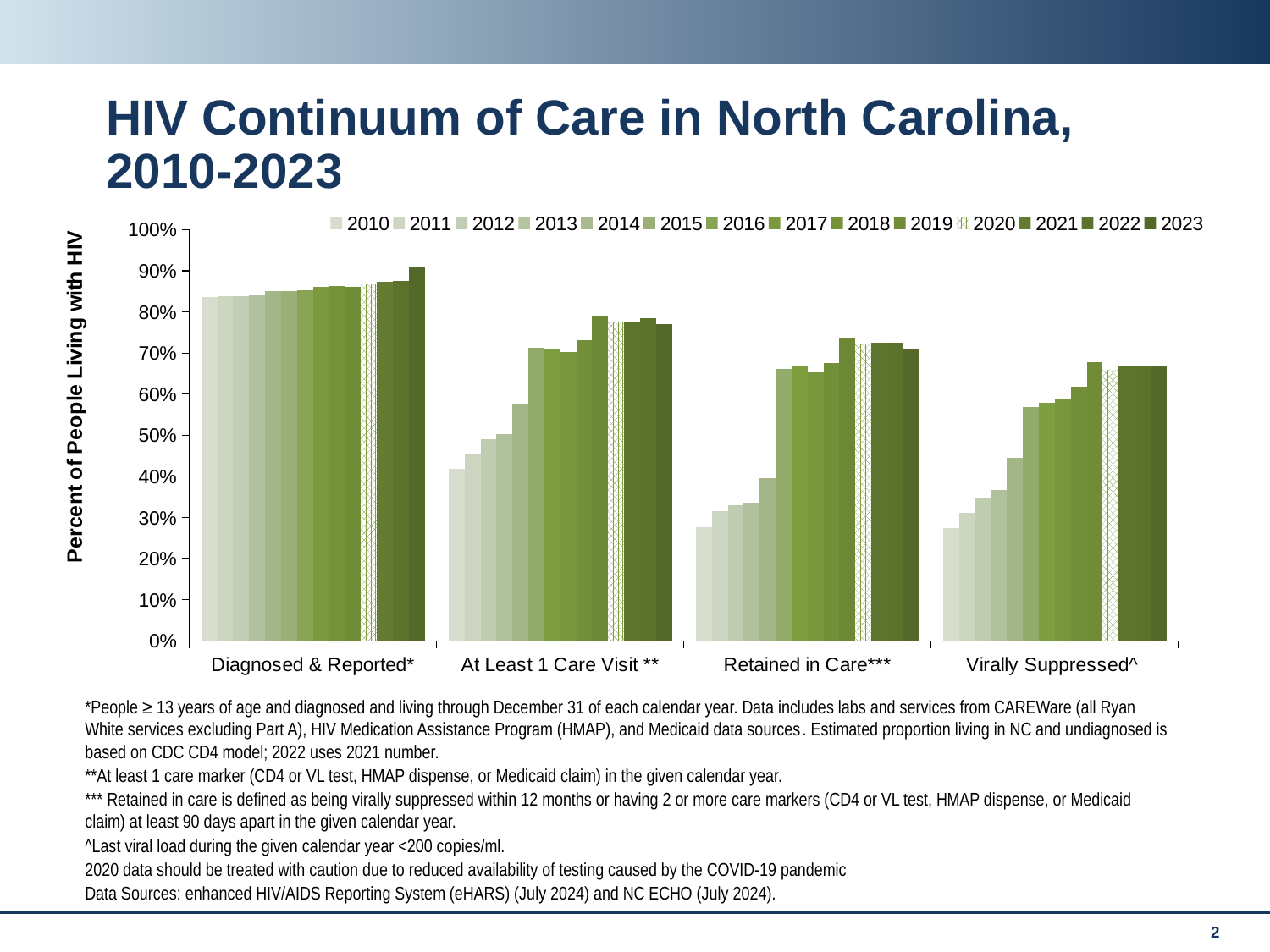
Do the Virally Suppressed values rise or fall from 2010 to 2023? rise What kind of chart is shown on the slide? Bar chart Is the value for Diagnosed & Reported in 2010 greater or less than 80%? greater What is the title of the y axis? Percent of People Living with HIV Is the value for At Least 1 Care Visit in 2010 greater or less than 50%? less Which is larger in 2023: Diagnosed & Reported or Virally Suppressed? Diagnosed & Reported Which category has the highest value in 2010? Diagnosed & Reported How many years (series) does the legend list? 14 Is the value for Virally Suppressed in 2010 greater or less than 30%? less How many categories are shown along the x axis? 4 Which category has the lowest value in 2023? Virally Suppressed